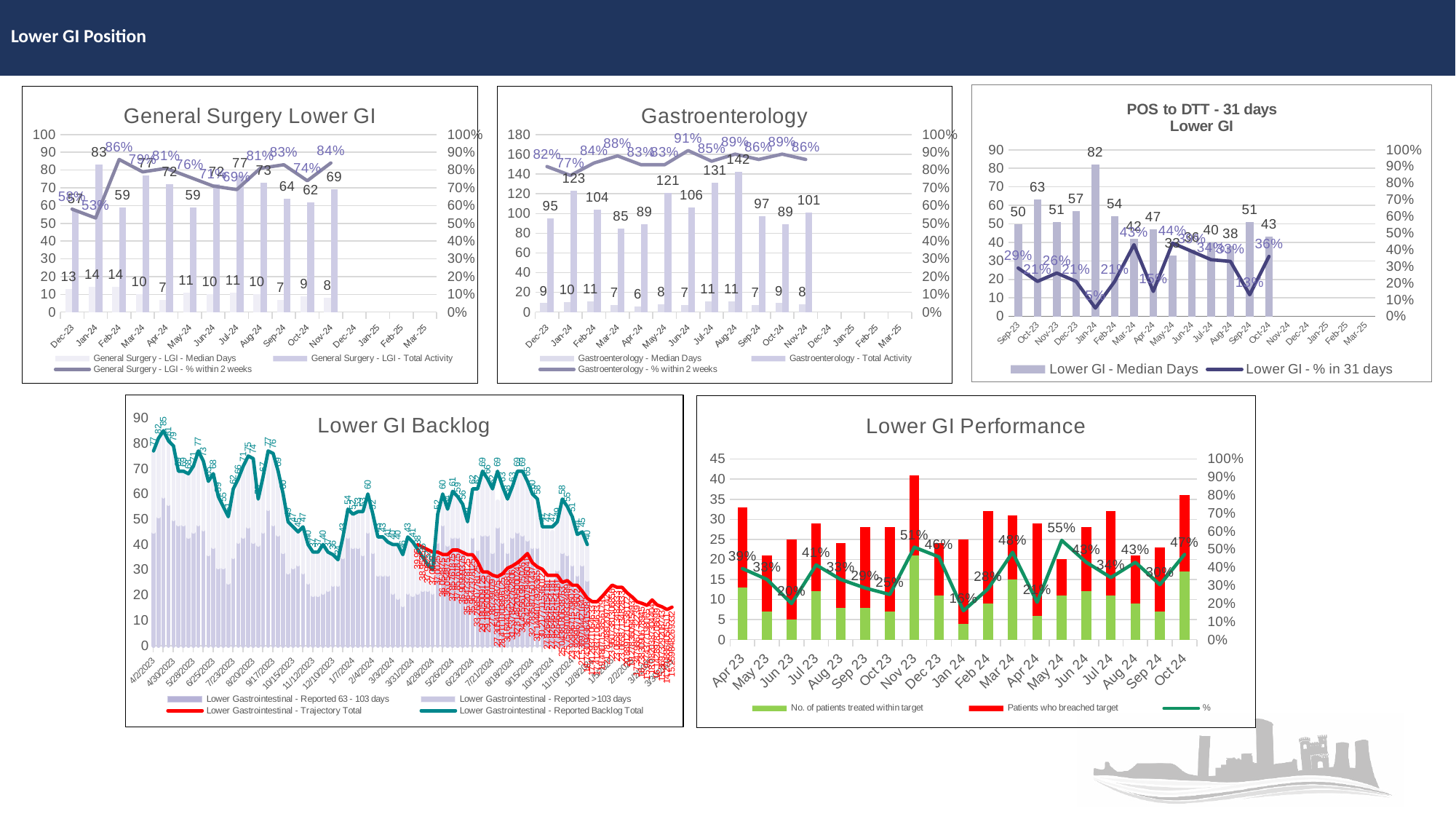
In the Gastroenterology chart, what was the Total Activity in Aug-24? 142 In the Lower GI Performance chart, how many months are shown on the x axis? 19 In the Lower GI Performance chart, is the % value for Nov 23 larger than the % value for Jan 24? Yes In the Gastroenterology chart, which month had the highest % within 2 weeks? Jun-24 In the Gastroenterology chart, what is the difference in Total Activity between Aug-24 and Sep-24? 45 In the Lower GI Performance chart, what was the % value in May 24? 55% In the General Surgery Lower GI chart, what was the % within 2 weeks in Nov-24? 84% In the POS to DTT - 31 days Lower GI chart, how many series does the legend list? 2 In the General Surgery Lower GI chart, what was the Total Activity in Jan-24? 83 In the POS to DTT - 31 days Lower GI chart, what was the Median Days value in Jan-24? 82 In the POS to DTT - 31 days Lower GI chart, which month had the lowest % in 31 days? Jan-24 In the General Surgery Lower GI chart, which month had the lowest % within 2 weeks? Jan-24